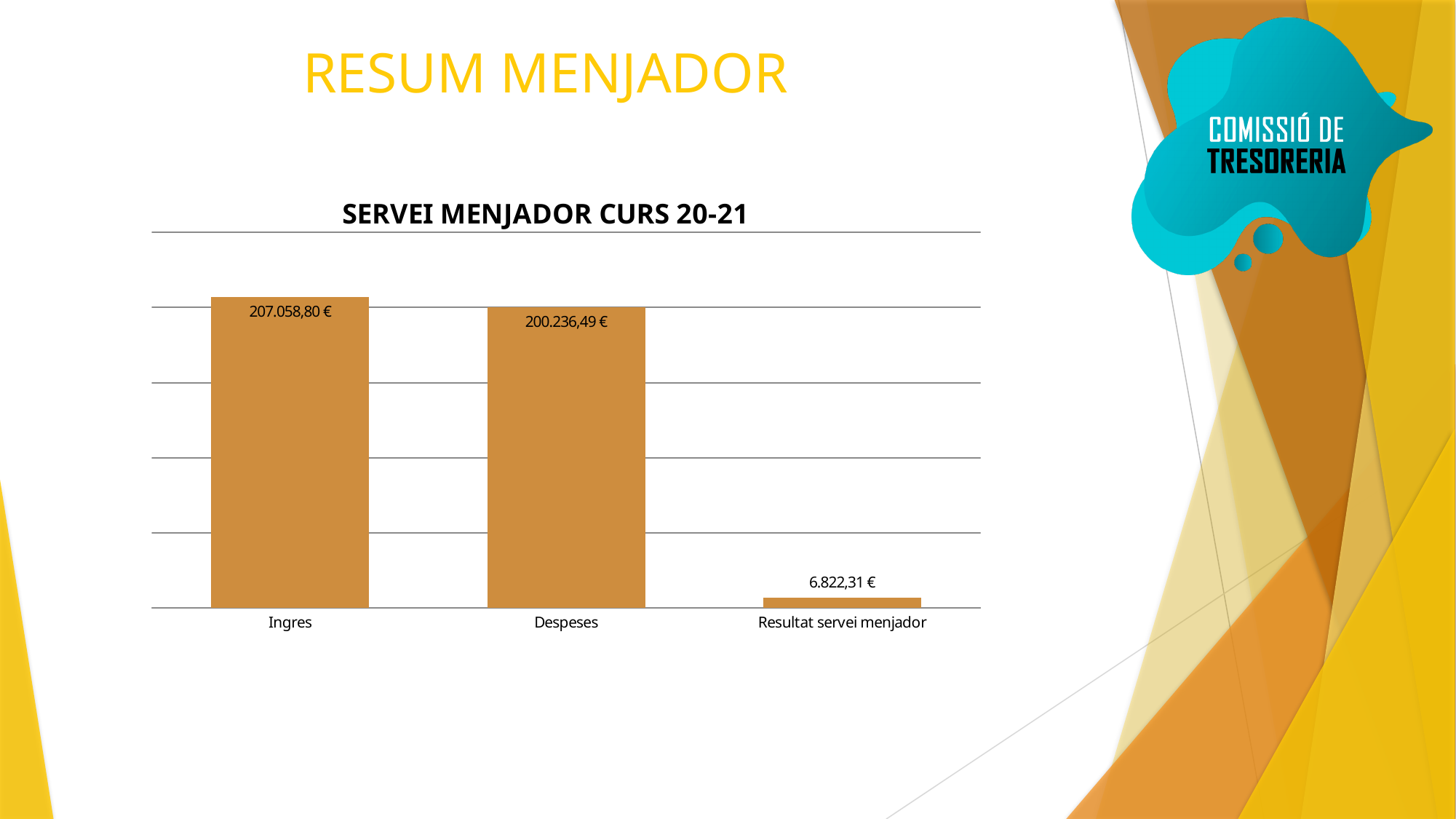
What is the value for Resultat servei menjador? 6.822,31 € How many categories are shown in the chart? 3 What is the value for Ingres? 207.058,80 € Which is larger, Despeses or Resultat servei menjador? Despeses Which category has the highest value? Ingres Which category has the lowest value? Resultat servei menjador What is the value for Despeses? 200.236,49 € What is the label of the third category on the x axis? Resultat servei menjador What kind of chart is shown on the slide? Bar chart Which is larger, Ingres or Despeses? Ingres What is the title of the chart? SERVEI MENJADOR CURS 20-21 What is the difference between Ingres and Despeses? 6.822,31 €